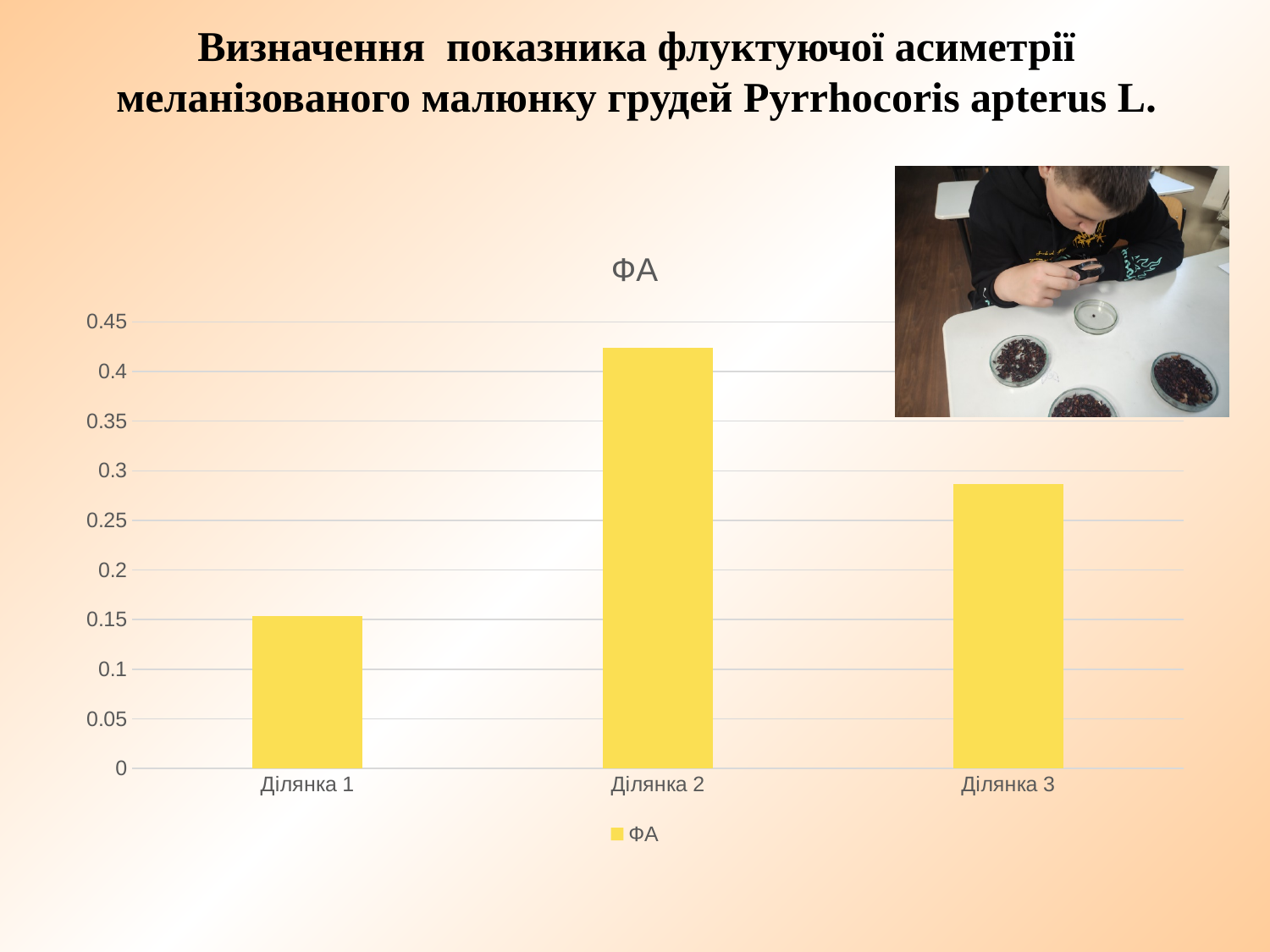
How many series does the chart legend list? 1 Which has a larger ФА value, Ділянка 2 or Ділянка 3? Ділянка 2 What kind of chart is shown on the slide? bar chart Which has a larger ФА value, Ділянка 1 or Ділянка 3? Ділянка 3 What is the title of the chart? ФА Is the value for Ділянка 1 greater or less than 0.2? less Which category has the lowest ФА value? Ділянка 1 Is the value for Ділянка 2 greater or less than 0.4? greater Which category has the highest ФА value? Ділянка 2 Is the value for Ділянка 3 greater or less than 0.25? greater How many categories are shown on the x axis of the chart? 3